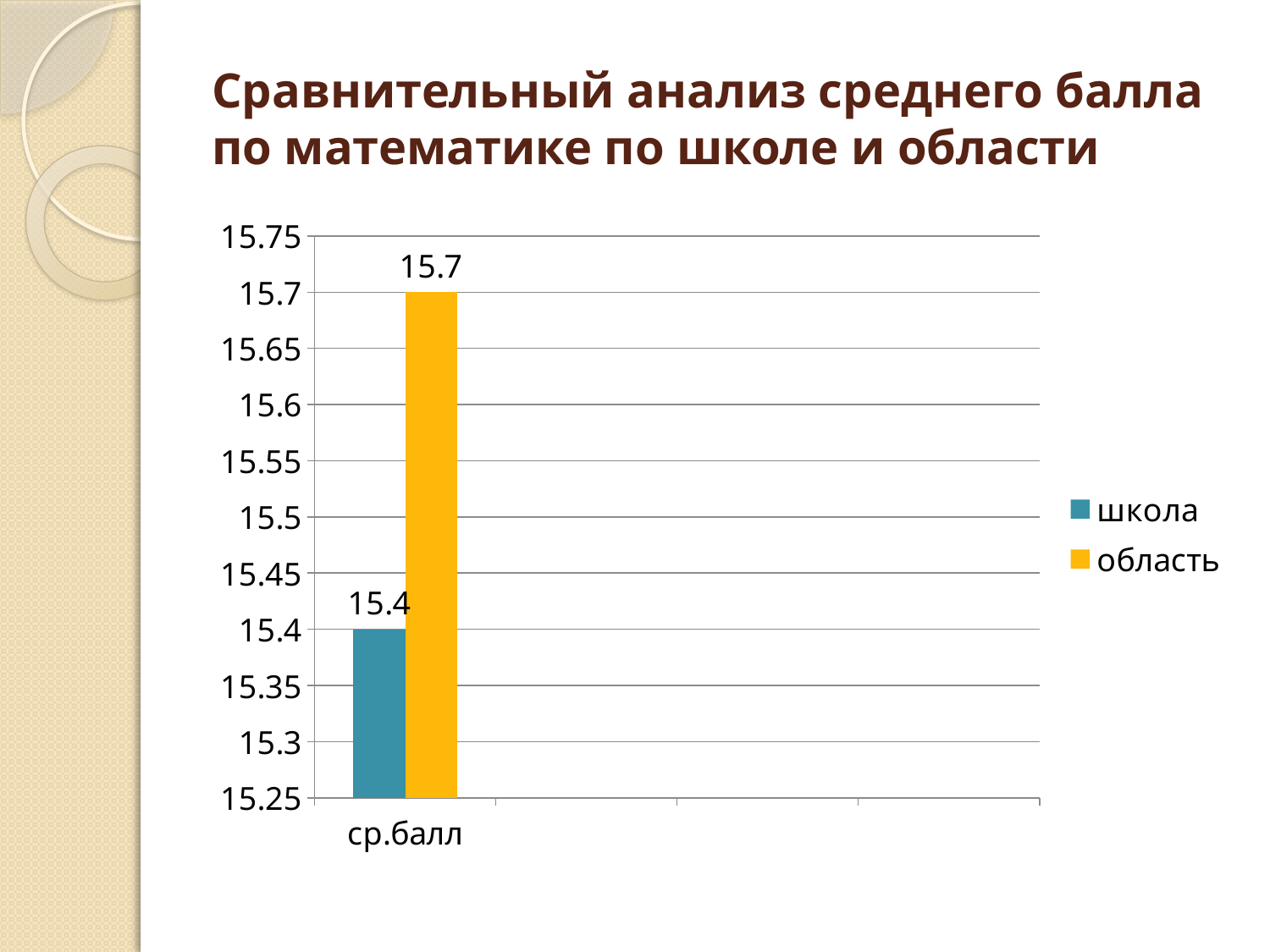
What is the value for область in the ср.балл category? 15.7 What kind of chart is shown on the slide? bar chart What colour is the bar for область? yellow Which series has the highest value? область Which series has the lowest value? школа How many series does the legend list? 2 What is the difference between the область value and the школа value? 0.3 Is the value for школа greater or less than 15.5? less How many categories are shown on the x axis? 1 Which series has the higher value: школа or область? область What is the value for школа in the ср.балл category? 15.4 Is the value for область greater or less than 15.6? greater